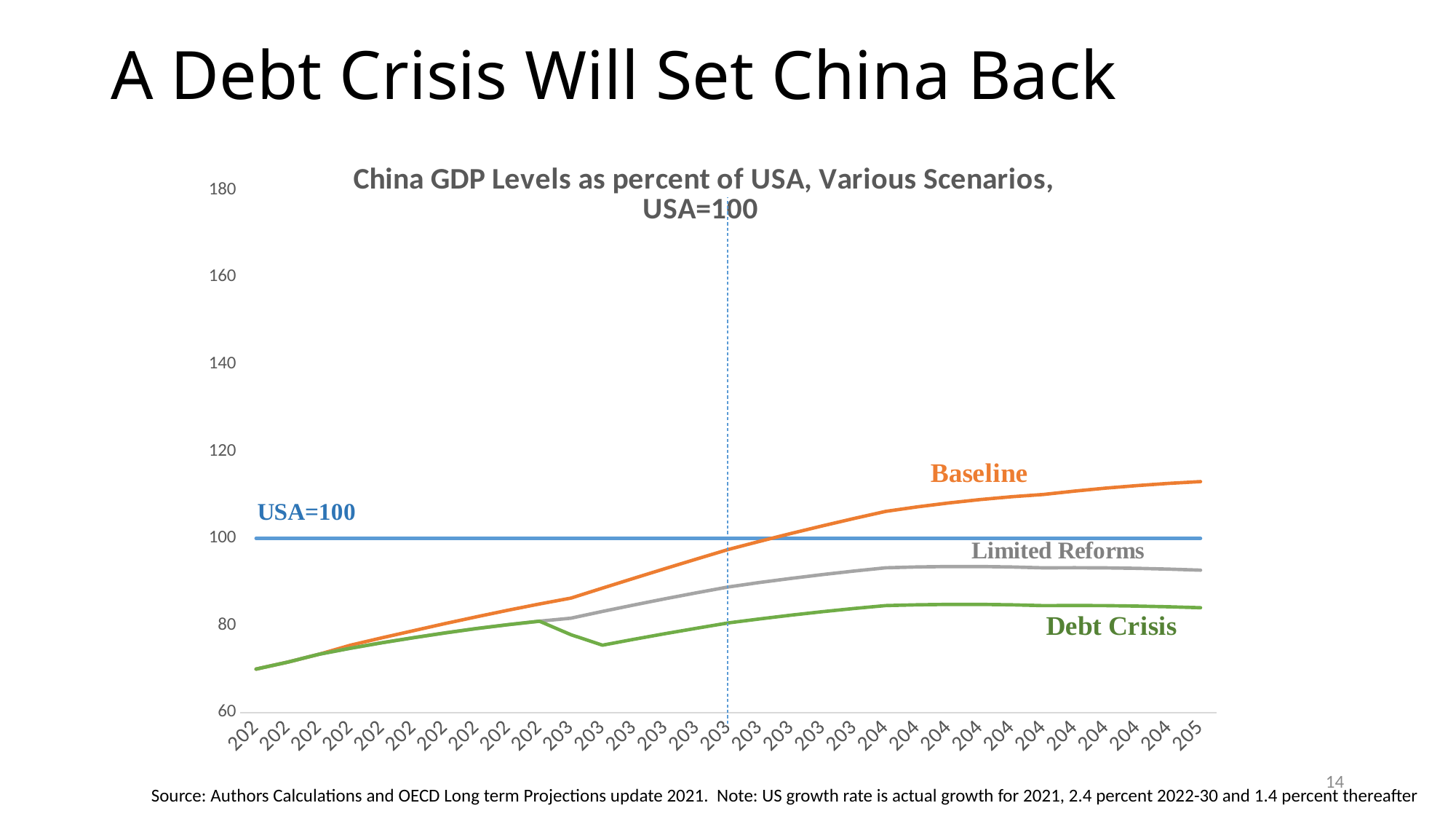
At the right end of the chart, is the Debt Crisis value greater or less than 100? less What is the title of the chart? China GDP Levels as percent of USA, Various Scenarios, USA=100 What kind of chart is shown on the slide? line chart At the right end of the chart, is the Limited Reforms value greater or less than 100? less What colour is the Debt Crisis line? green Which scenario line is highest at the right end of the chart? Baseline Which scenario line is lowest at the right end of the chart? Debt Crisis How many series are plotted on the chart? 4 At the right end of the chart, is the Baseline value greater or less than 100? greater Does the Baseline line rise or fall from left to right across the chart? rise What value does the flat blue USA line sit at? 100 At the right end of the chart, which is larger, the Baseline value or the Limited Reforms value? Baseline